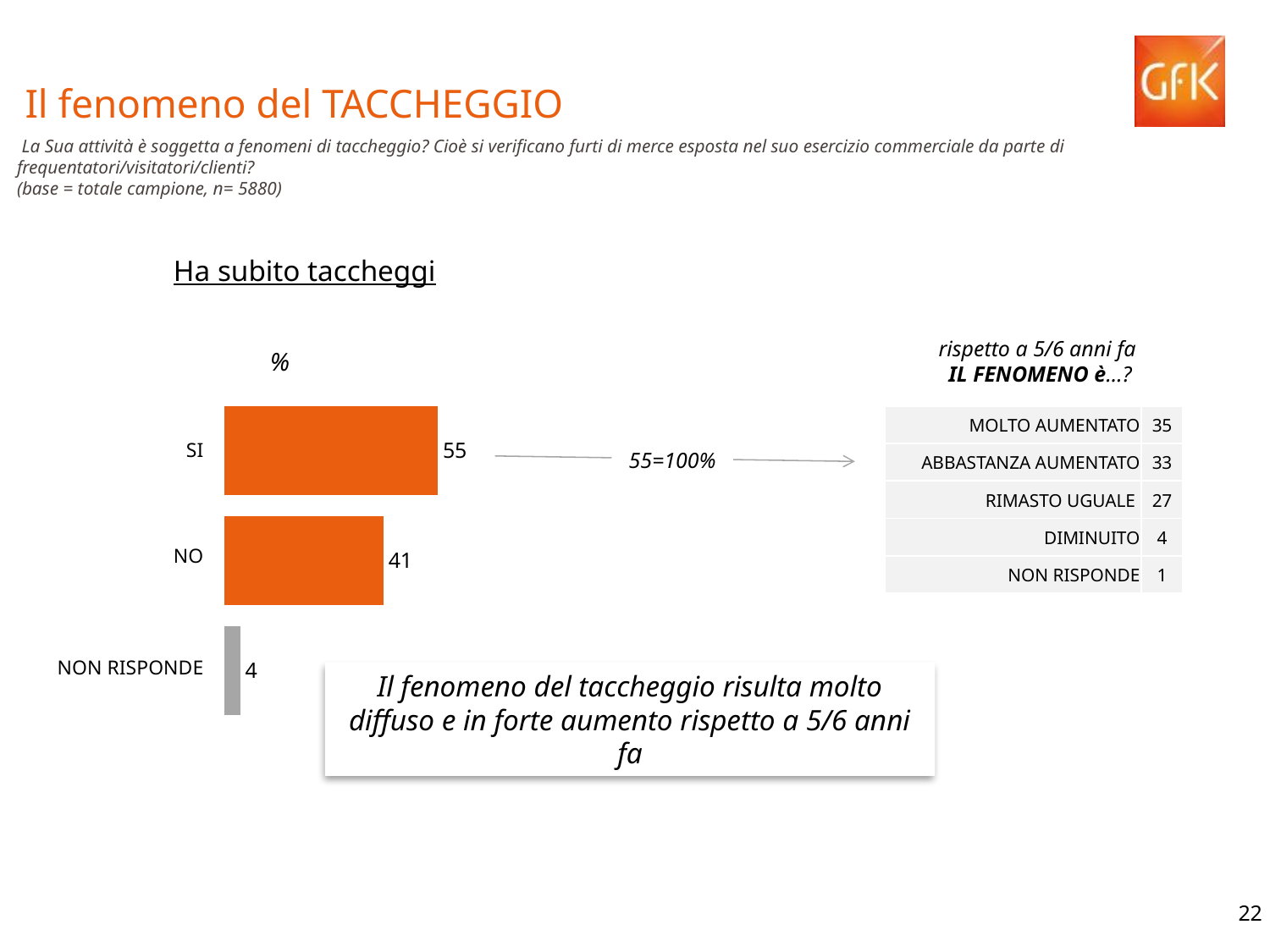
In the 'Ha subito taccheggi' chart, what is the difference between the values for NO and NON RISPONDE? 37 Which category has the lowest value in the 'Ha subito taccheggi' chart? NON RISPONDE In the 'Ha subito taccheggi' chart, which is larger, the value for SI or the value for NO? SI In the 'Ha subito taccheggi' chart, which bar is coloured grey rather than orange? NON RISPONDE Which category has the highest value in the 'Ha subito taccheggi' chart? SI How many categories are shown in the 'Ha subito taccheggi' chart? 3 In the 'Ha subito taccheggi' chart, what is the value for NON RISPONDE? 4 What type of chart is 'Ha subito taccheggi'? Bar chart In the 'Ha subito taccheggi' chart, what is the value for NO? 41 In the 'Ha subito taccheggi' chart, what is the value for SI? 55 In the 'Ha subito taccheggi' chart, what is the total of the three bar values? 100 In the 'Ha subito taccheggi' chart, what is the difference between the values for SI and NO? 14